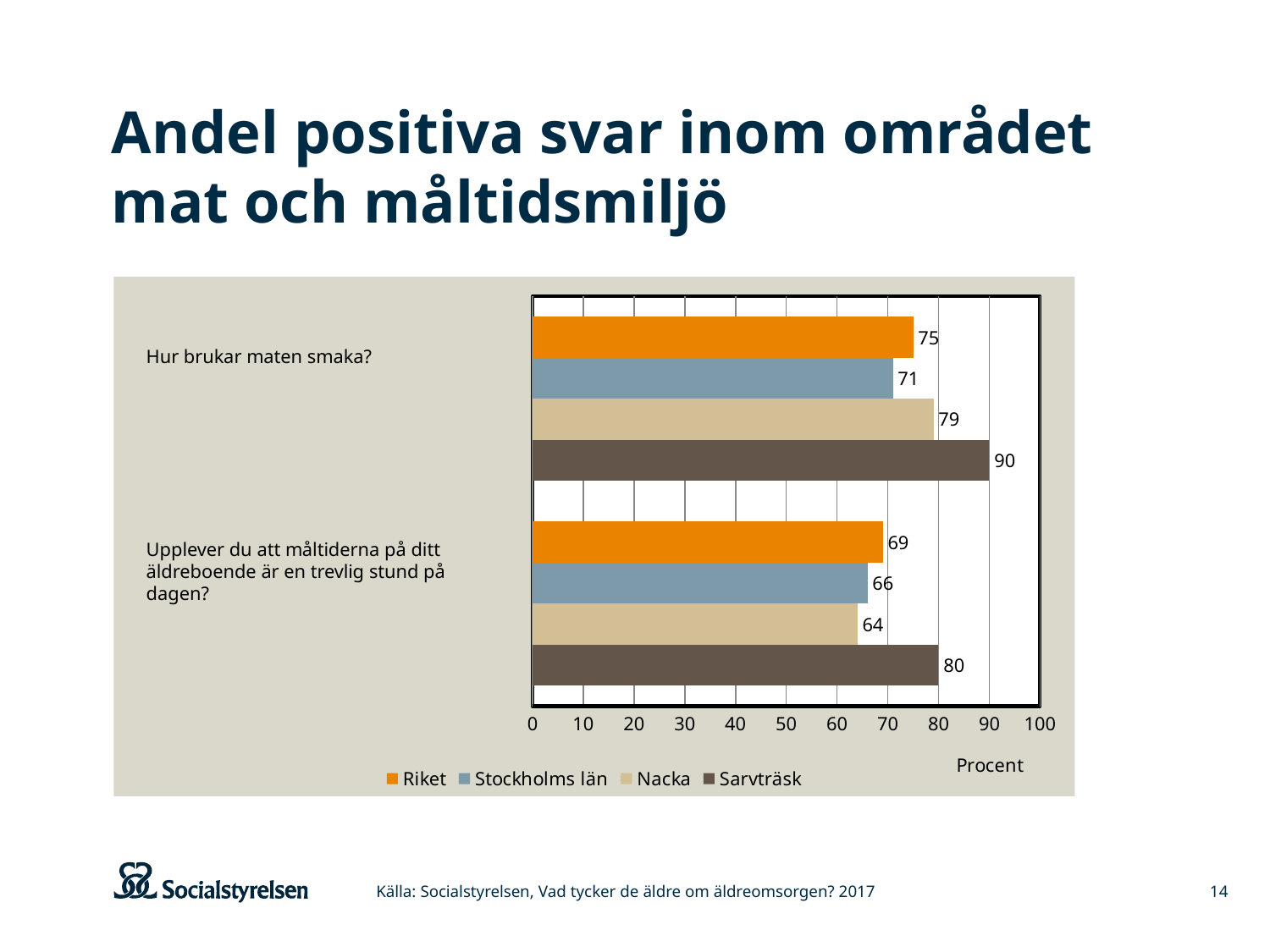
What is the difference between the Sarvträsk and Riket values for the question "Hur brukar maten smaka?"? 15 How many series does the legend list? 4 Which is larger for the question "Upplever du att måltiderna på ditt äldreboende är en trevlig stund på dagen?": Riket or Stockholms län? Riket Which series has the highest value for the question "Hur brukar maten smaka?"? Sarvträsk What kind of chart is shown on the slide? Bar chart What is the label on the horizontal axis of the chart? Procent What is the value for Sarvträsk for the question "Hur brukar maten smaka?"? 90 What is the value for Stockholms län for the question "Upplever du att måltiderna på ditt äldreboende är en trevlig stund på dagen?"? 66 What is the difference between the Sarvträsk values for the two questions? 10 What is the value for Nacka for the question "Upplever du att måltiderna på ditt äldreboende är en trevlig stund på dagen?"? 64 Which series has the lowest value for the question "Upplever du att måltiderna på ditt äldreboende är en trevlig stund på dagen?"? Nacka What is the value for Riket for the question "Hur brukar maten smaka?"? 75